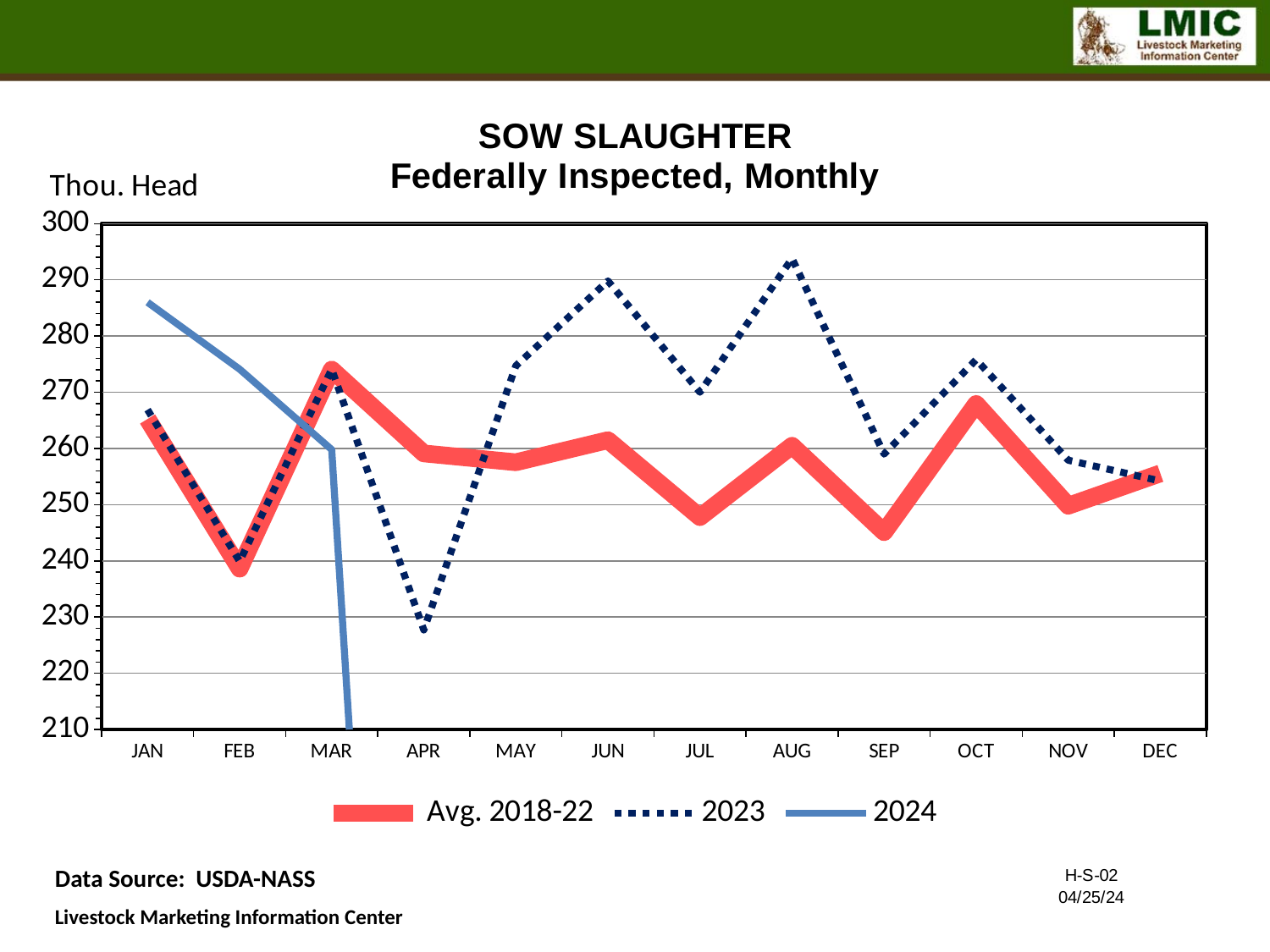
Does the 2024 series rise or fall from JAN to MAR? fall What unit label is shown on the y axis? Thou. Head In which month does the 2023 series reach its lowest value? APR How many series does the legend list? 3 What kind of chart is shown on the slide? line chart In which month is the Avg. 2018-22 series at its lowest? FEB In JUN, which series has the larger value: 2023 or Avg. 2018-22? 2023 Is the 2024 value for JAN greater or less than 280? greater How many months are shown along the x axis? 12 In which month does the 2023 series reach its highest value? AUG Is the 2023 value for AUG greater or less than 280? greater Is the 2023 value for APR greater or less than 240? less